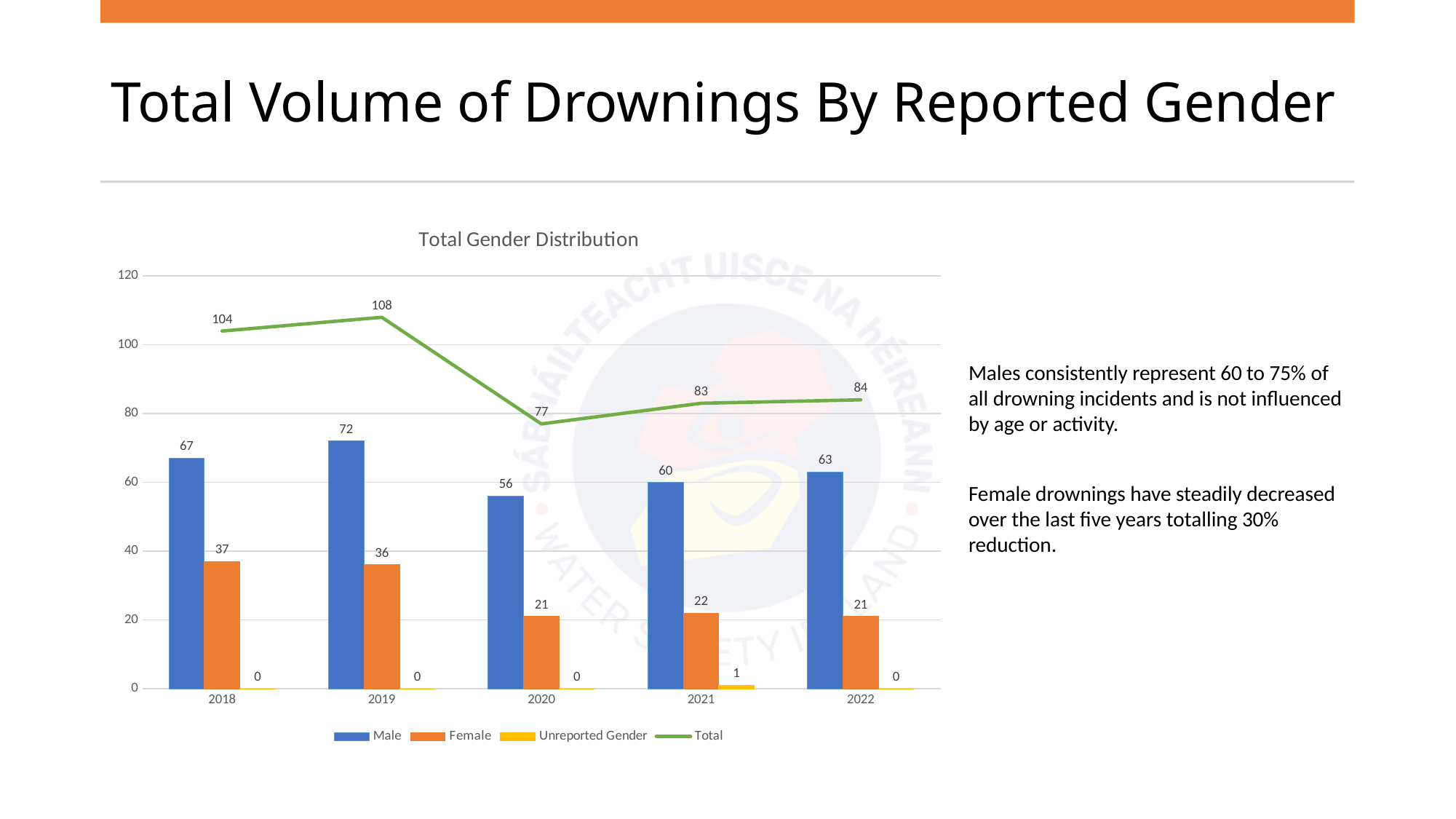
In which year is the Total highest? 2019 What is the Female value for 2021? 22 How many years are shown on the x axis? 5 Which is larger, the Female value in 2019 or the Female value in 2022? 2019 What is the Total value for 2020? 77 What is the Male value for 2019? 72 What is the title of the chart? Total Gender Distribution What is the Unreported Gender value for 2021? 1 What kind of chart is shown? Combined bar and line chart In which year is the Male value lowest? 2020 How many series does the legend list? 4 What is the difference between the Male and Female values in 2018? 30